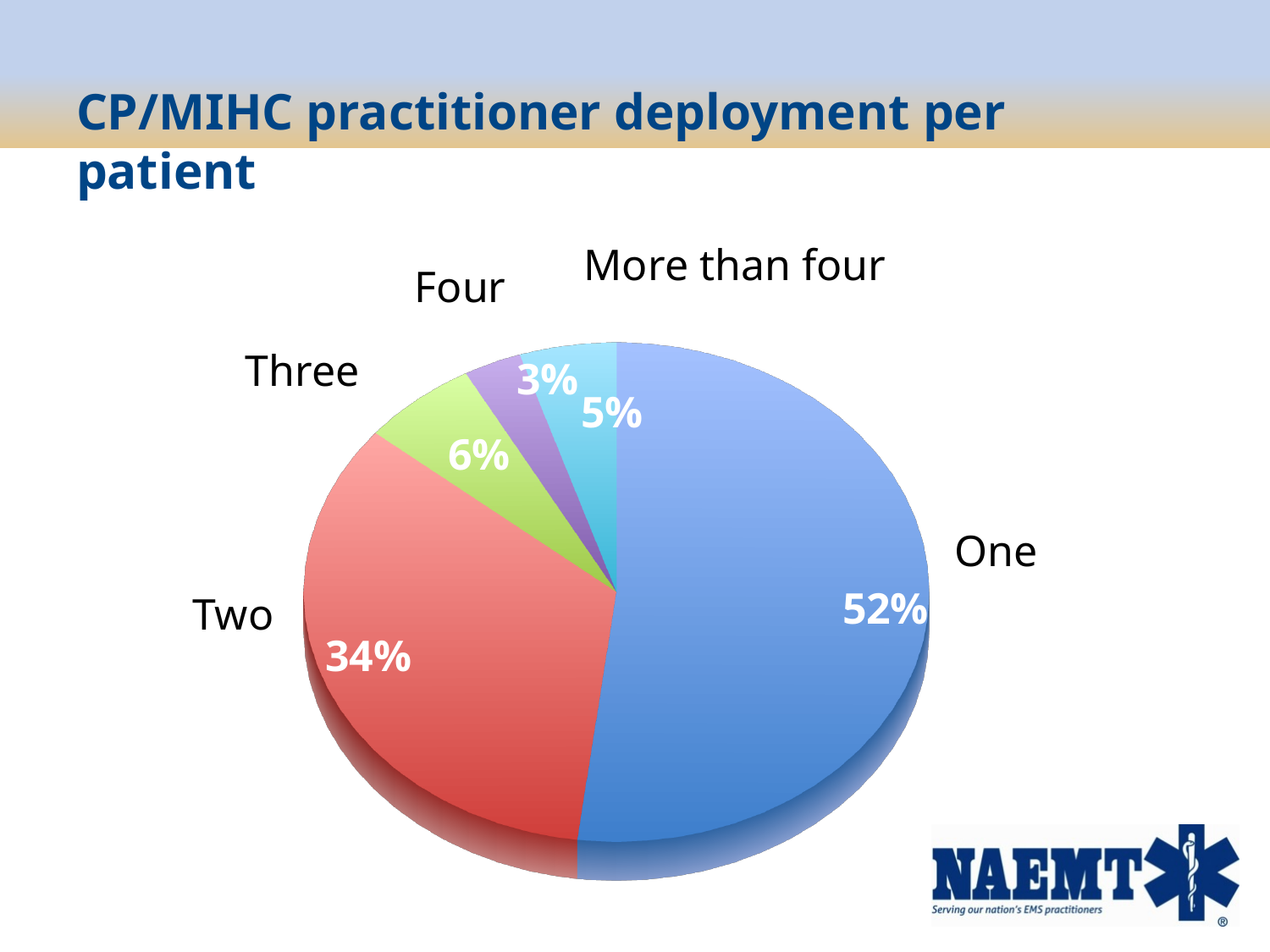
What is the difference in percentage points between the 'One' and 'Two' slices? 18 What percentage of patients had one CP/MIHC practitioner deployed? 52% Which slice is larger, 'Three' or 'More than four'? Three What percentage is shown for the 'Four' slice? 3% How many categories are shown in the pie chart? 5 What is the title of the chart on the slide? CP/MIHC practitioner deployment per patient What percentage is shown for the 'More than four' slice? 5% What percentage is shown for the 'Three' slice? 6% Which category has the smallest share of the pie? Four Which category has the largest share of the pie? One What type of chart is shown on the slide? Pie chart What percentage is shown for the 'Two' slice? 34%